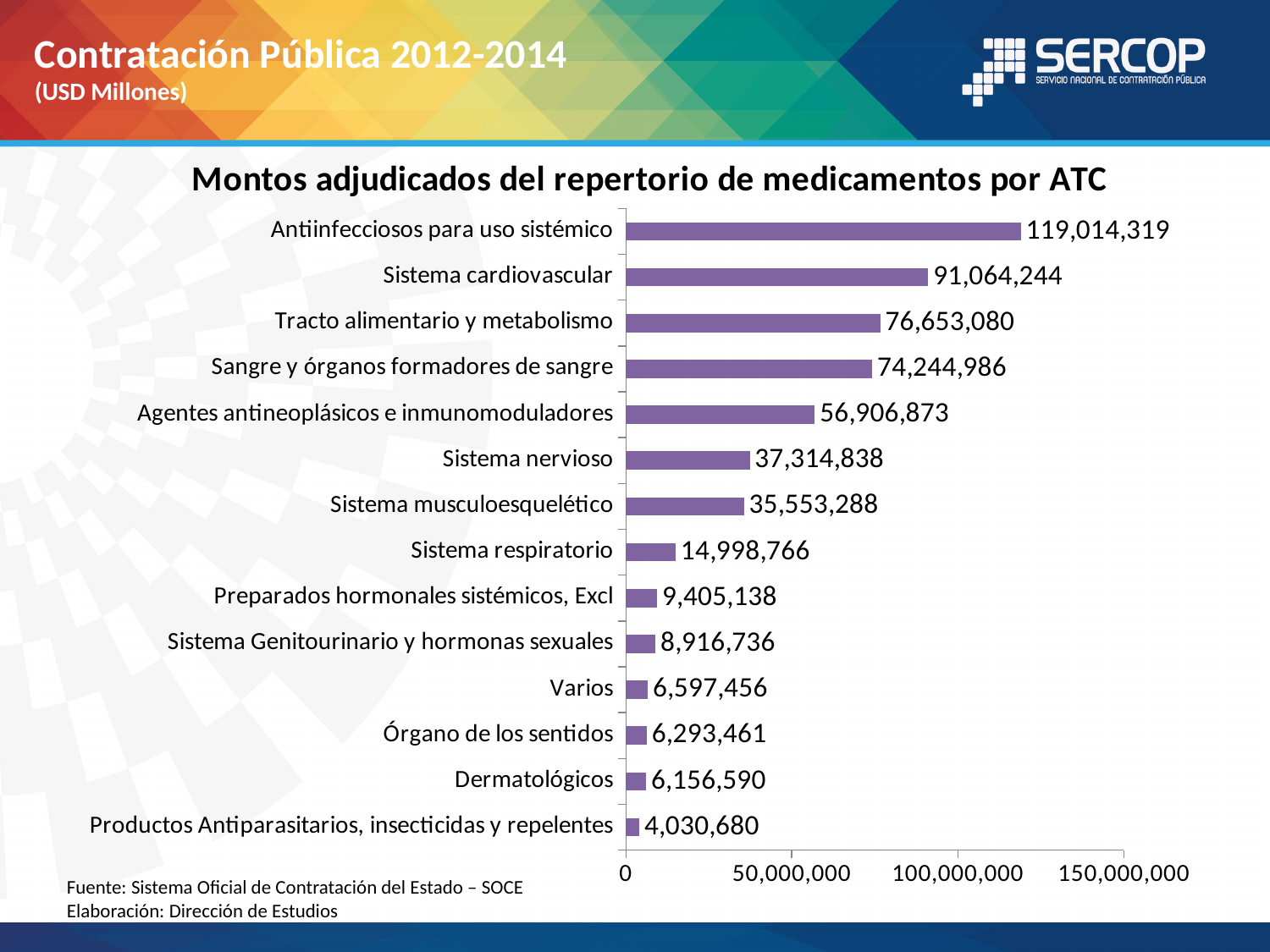
What is the value for Dermatológicos? 6,156,590 Which category has the highest value? Antiinfecciosos para uso sistémico What kind of chart is shown on the slide? bar chart What is the value for Sistema nervioso? 37,314,838 Which category has the lowest value? Productos Antiparasitarios, insecticidas y repelentes How many categories are shown in the chart? 14 What is the title of the chart? Montos adjudicados del repertorio de medicamentos por ATC Which is larger, Sistema respiratorio or Sistema musculoesquelético? Sistema musculoesquelético Is the value for Sistema cardiovascular greater or less than 50,000,000? greater What is the difference between Tracto alimentario y metabolismo and Sangre y órganos formadores de sangre? 2,408,094 What is the value for Antiinfecciosos para uso sistémico? 119,014,319 What is the difference between Antiinfecciosos para uso sistémico and Sistema cardiovascular? 27,950,075